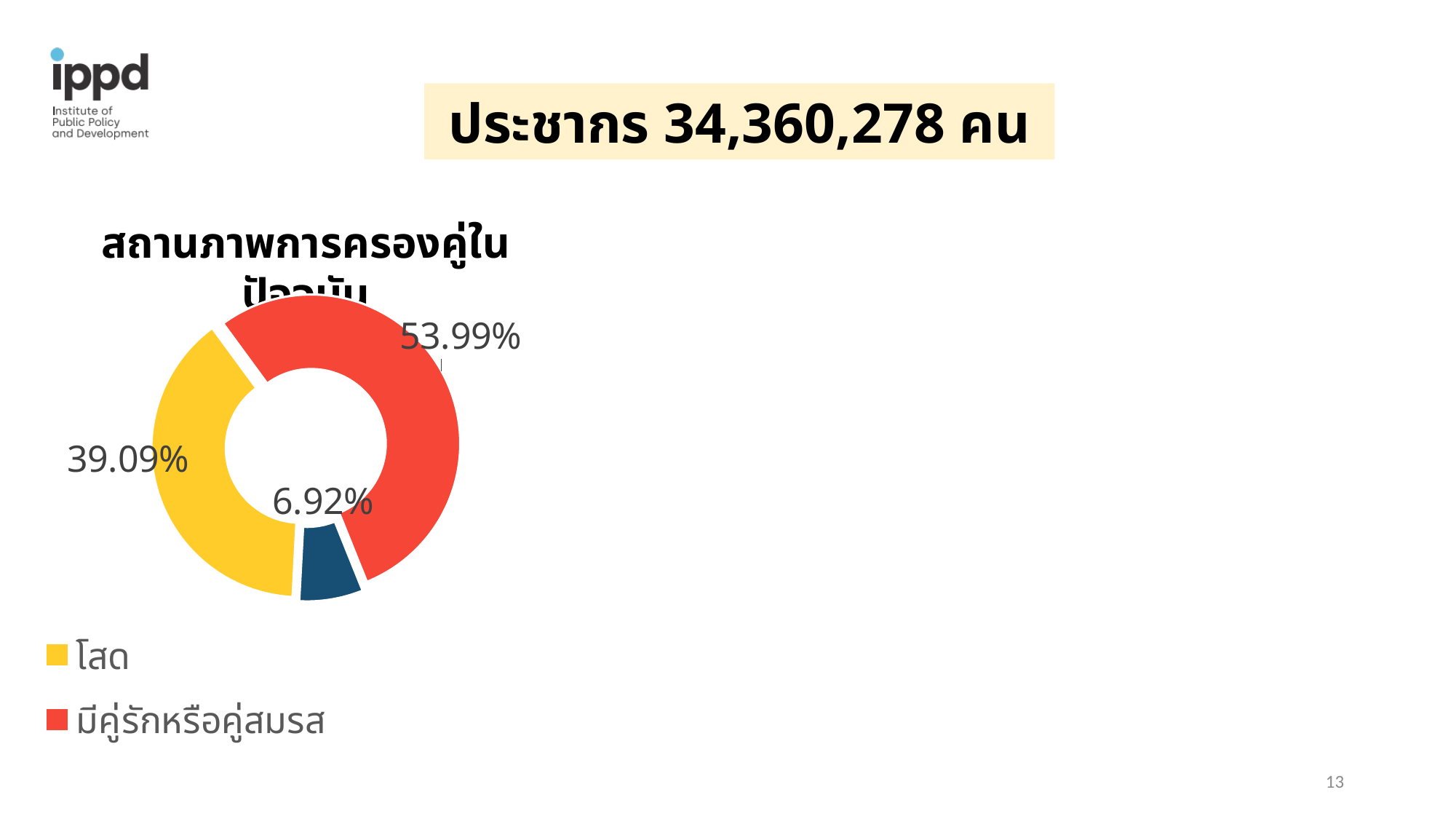
What colour represents โสด in the chart? Yellow What is the smallest percentage shown on the doughnut chart? 6.92% What kind of chart is shown on the slide? Doughnut (pie) chart Which is larger in the doughnut chart, โสด or มีคู่รักหรือคู่สมรส? มีคู่รักหรือคู่สมรส How many entries does the chart legend list? 2 What percentage of the doughnut chart is labelled มีคู่รักหรือคู่สมรส? 53.99% What percentage of the doughnut chart is labelled โสด? 39.09% What is the population figure shown at the top of the slide? 34,360,278 คน Which category has the largest share in the doughnut chart? มีคู่รักหรือคู่สมรส What is the difference in percentage points between มีคู่รักหรือคู่สมรส and โสด? 14.90% What is the title of the chart? สถานภาพการครองคู่ในปัจจุบัน How many slices does the doughnut chart have? 3